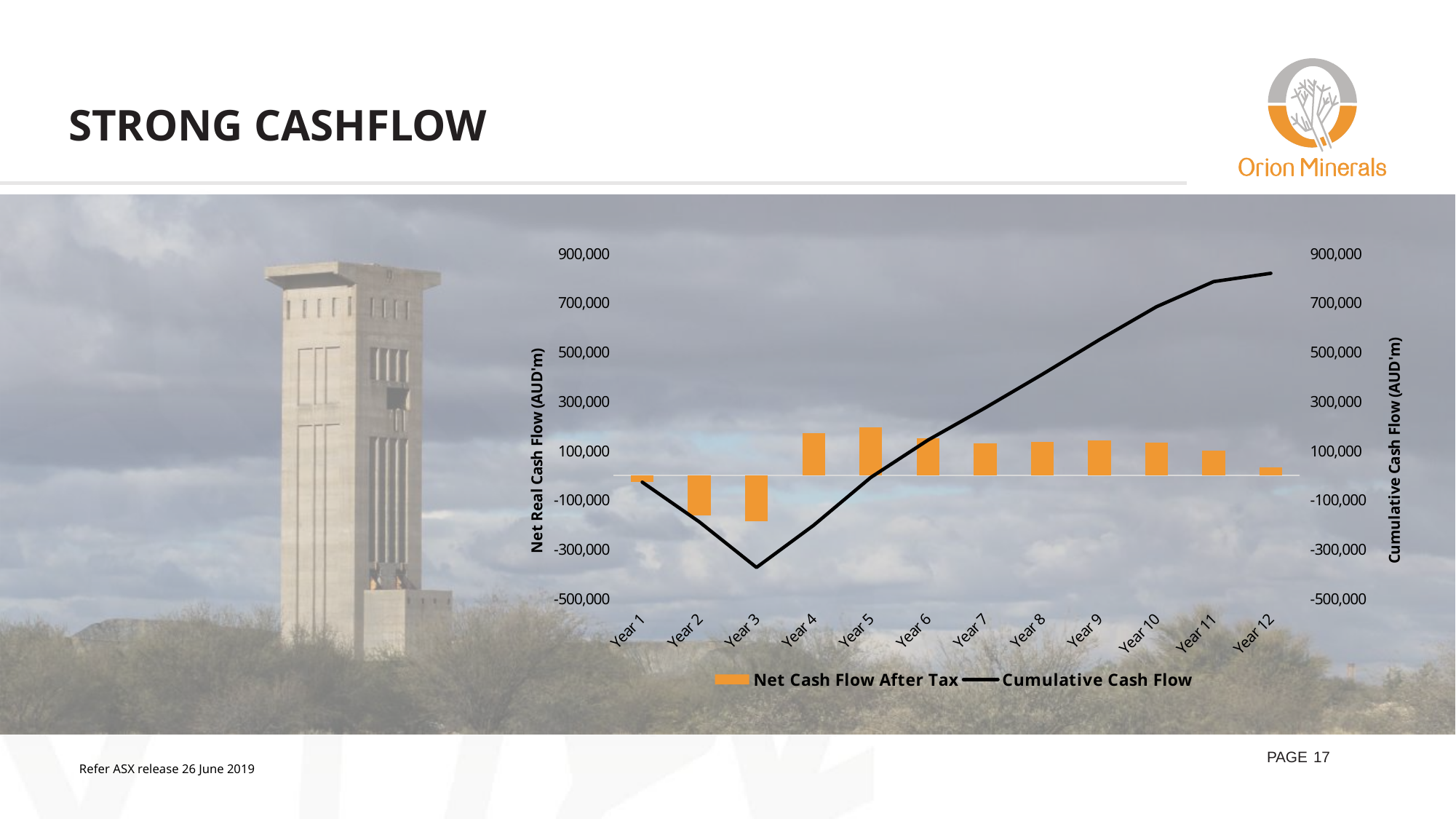
Is the Net Cash Flow After Tax value for Year 5 greater or less than 100,000? greater Is the Cumulative Cash Flow value for Year 12 greater or less than 700,000? greater What is the title of the left vertical axis? Net Real Cash Flow (AUD'm) Is the Net Cash Flow After Tax value for Year 2 greater or less than -100,000? less In which year is the Cumulative Cash Flow line at its highest point? Year 12 In which year is the Cumulative Cash Flow line at its lowest point? Year 3 How many years are shown on the x axis of the chart? 12 What kind of chart is shown on the slide? Combined bar and line chart Which series is drawn as a line in the chart? Cumulative Cash Flow How many series does the chart legend list? 2 Which is larger, the Net Cash Flow After Tax bar for Year 5 or for Year 12? Year 5